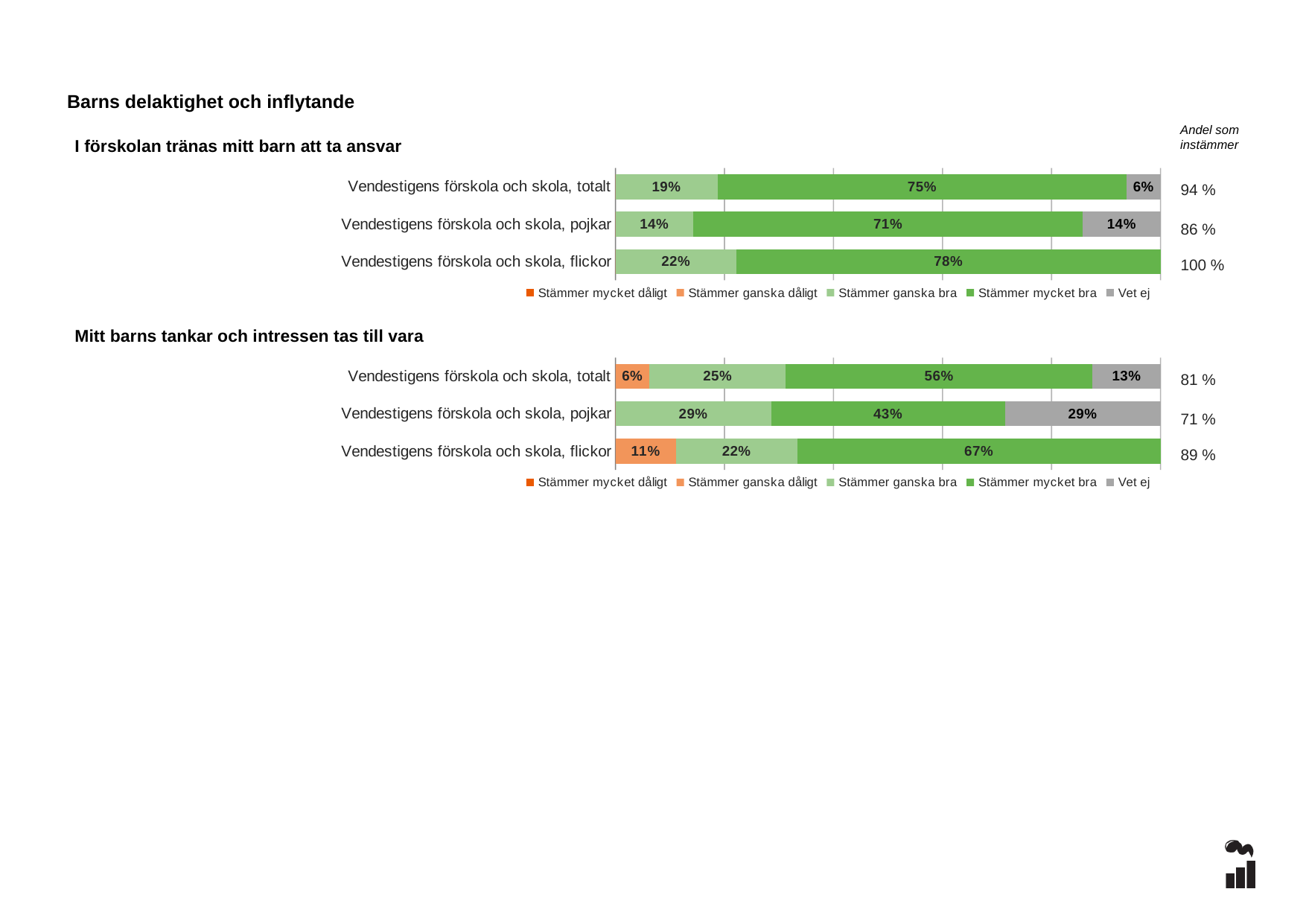
How many categories are shown in the chart 'Mitt barns tankar och intressen tas till vara'? 3 How many series does the legend of the chart 'I förskolan tränas mitt barn att ta ansvar' list? 5 What kind of chart is 'Mitt barns tankar och intressen tas till vara'? Stacked bar chart In the chart 'I förskolan tränas mitt barn att ta ansvar', what is the 'Stämmer mycket bra' value for Vendestigens förskola och skola, totalt? 75% In the chart 'I förskolan tränas mitt barn att ta ansvar', is the 'Stämmer ganska bra' value larger for totalt or for pojkar? totalt In the chart 'I förskolan tränas mitt barn att ta ansvar', what is the 'Vet ej' value for Vendestigens förskola och skola, pojkar? 14% In the chart 'I förskolan tränas mitt barn att ta ansvar', which category has the lowest 'Stämmer mycket bra' value? Vendestigens förskola och skola, pojkar In the chart 'Mitt barns tankar och intressen tas till vara', what is the 'Stämmer mycket bra' value for Vendestigens förskola och skola, pojkar? 43% In the chart 'Mitt barns tankar och intressen tas till vara', what is the 'Stämmer ganska dåligt' value for Vendestigens förskola och skola, flickor? 11% In the chart 'Mitt barns tankar och intressen tas till vara', which category has the highest 'Vet ej' value? Vendestigens förskola och skola, pojkar In the chart 'Mitt barns tankar och intressen tas till vara', what is the difference between the 'Stämmer mycket bra' values for flickor and pojkar? 24% In the chart 'I förskolan tränas mitt barn att ta ansvar', what is the 'Stämmer ganska bra' value for Vendestigens förskola och skola, flickor? 22%